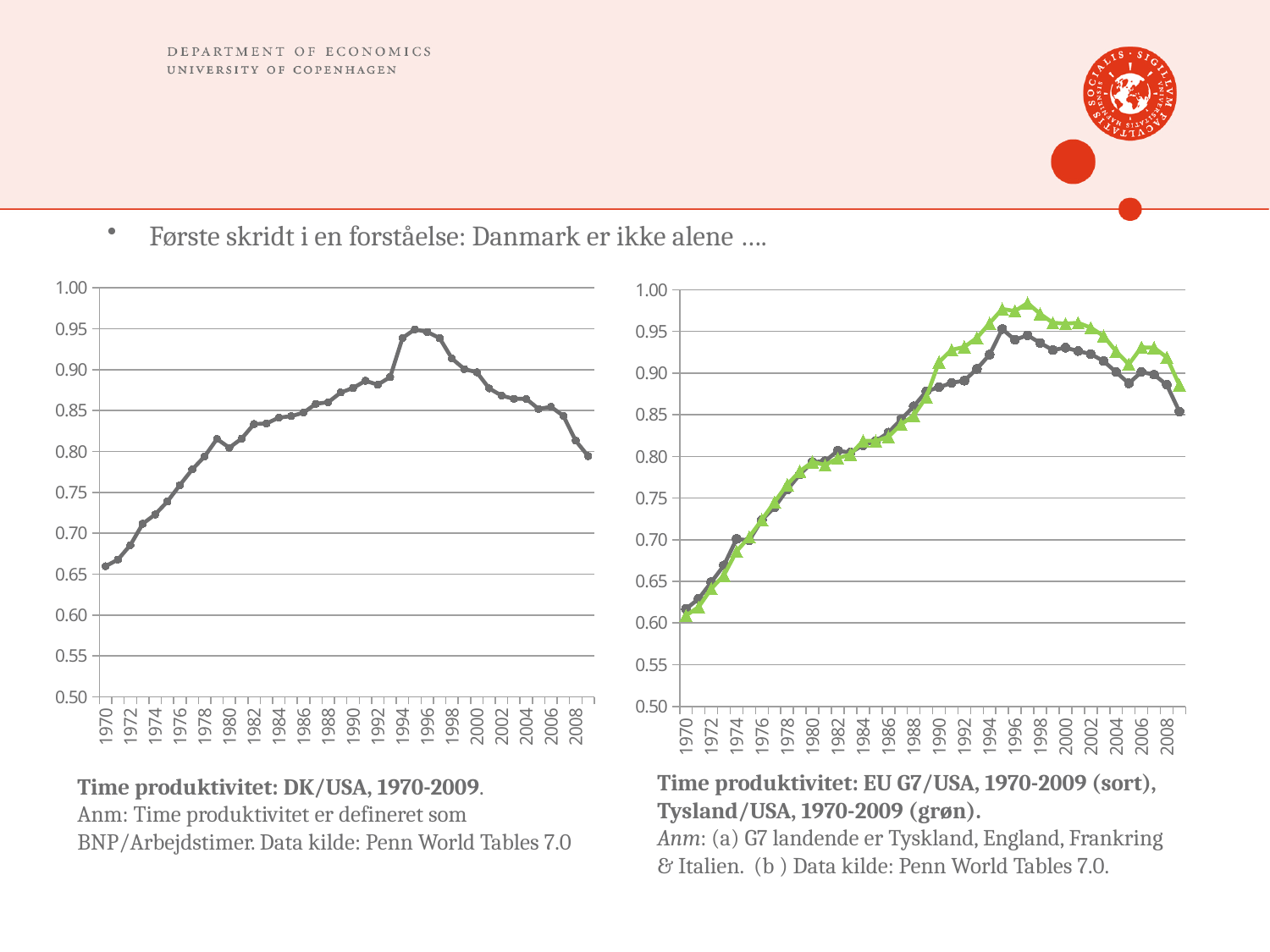
In the left chart (DK/USA), does the series rise or fall between 1995 and 2009? fall In the left chart (DK/USA), does the series rise or fall between 1970 and 1995? rise In the left chart (DK/USA), is the value for 2009 greater or less than 0.85? less In the left chart (DK/USA), is the value for 1995 greater or less than 0.90? greater In the right chart, which series is higher in 2009, EU G7/USA (black) or Tysland/USA (green)? Tysland/USA (green) What kind of chart is the right chart (Time produktivitet: EU G7/USA, Tysland/USA)? line chart In the right chart, is the green Tysland/USA value for 1997 greater or less than 0.95? greater According to the caption, which colour represents Tysland/USA in the right chart? green (grøn) What kind of chart is the left chart (Time produktivitet: DK/USA)? line chart How many series are plotted in the right chart (EU G7/USA and Tysland/USA)? 2